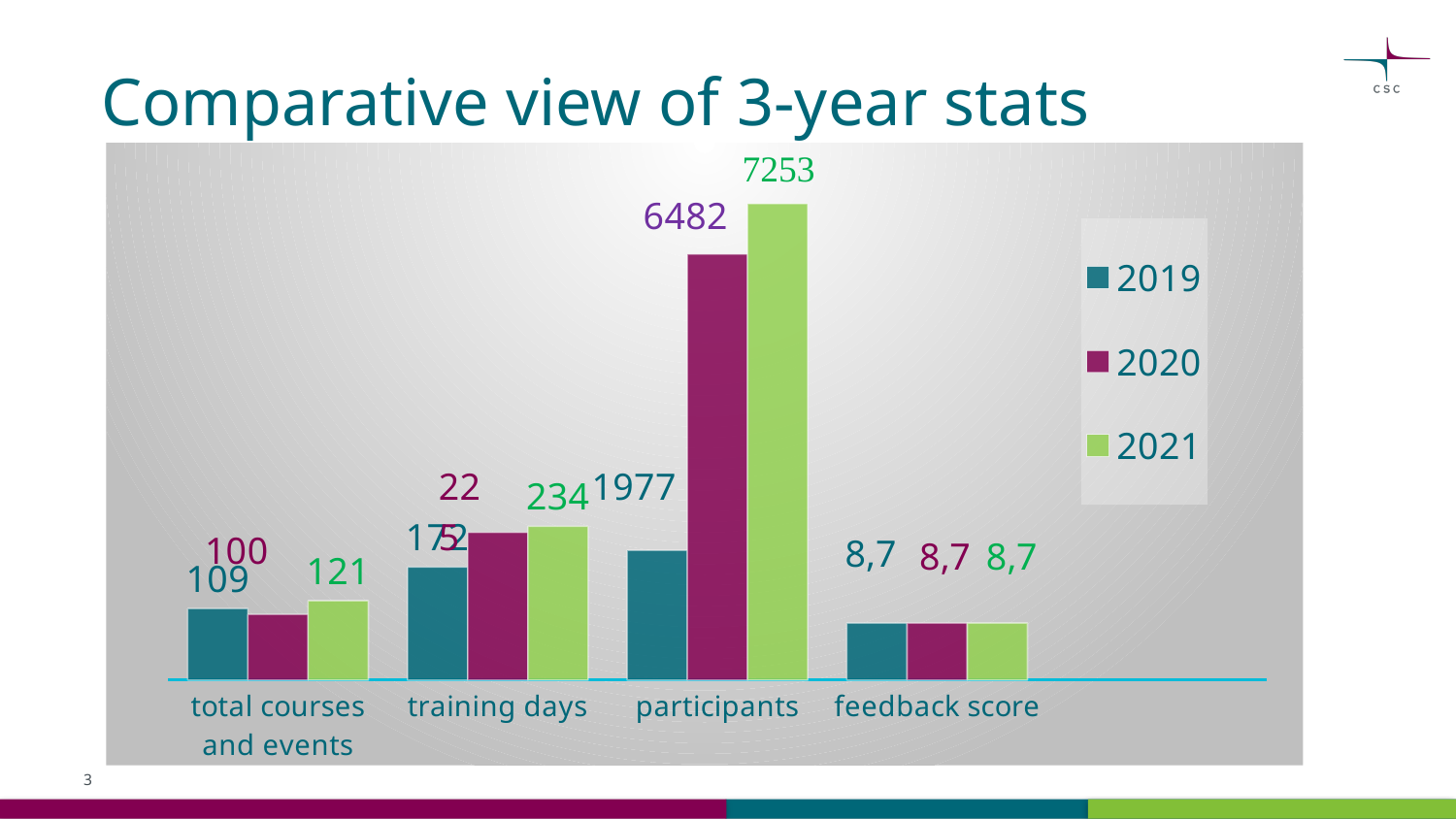
What type of chart is shown on the slide? bar chart What is the value for participants in 2019? 1977 What is the value for total courses and events in 2021? 121 How many series does the legend list? 3 What is the value for participants in 2020? 6482 What is the feedback score for 2020? 8,7 What is the value for participants in 2021? 7253 What is the value for training days in 2021? 234 Which year has the highest number of participants? 2021 How many categories are shown on the x axis? 4 What is the difference between participants in 2021 and participants in 2020? 771 Which is larger: total courses and events in 2019 or in 2020? 2019